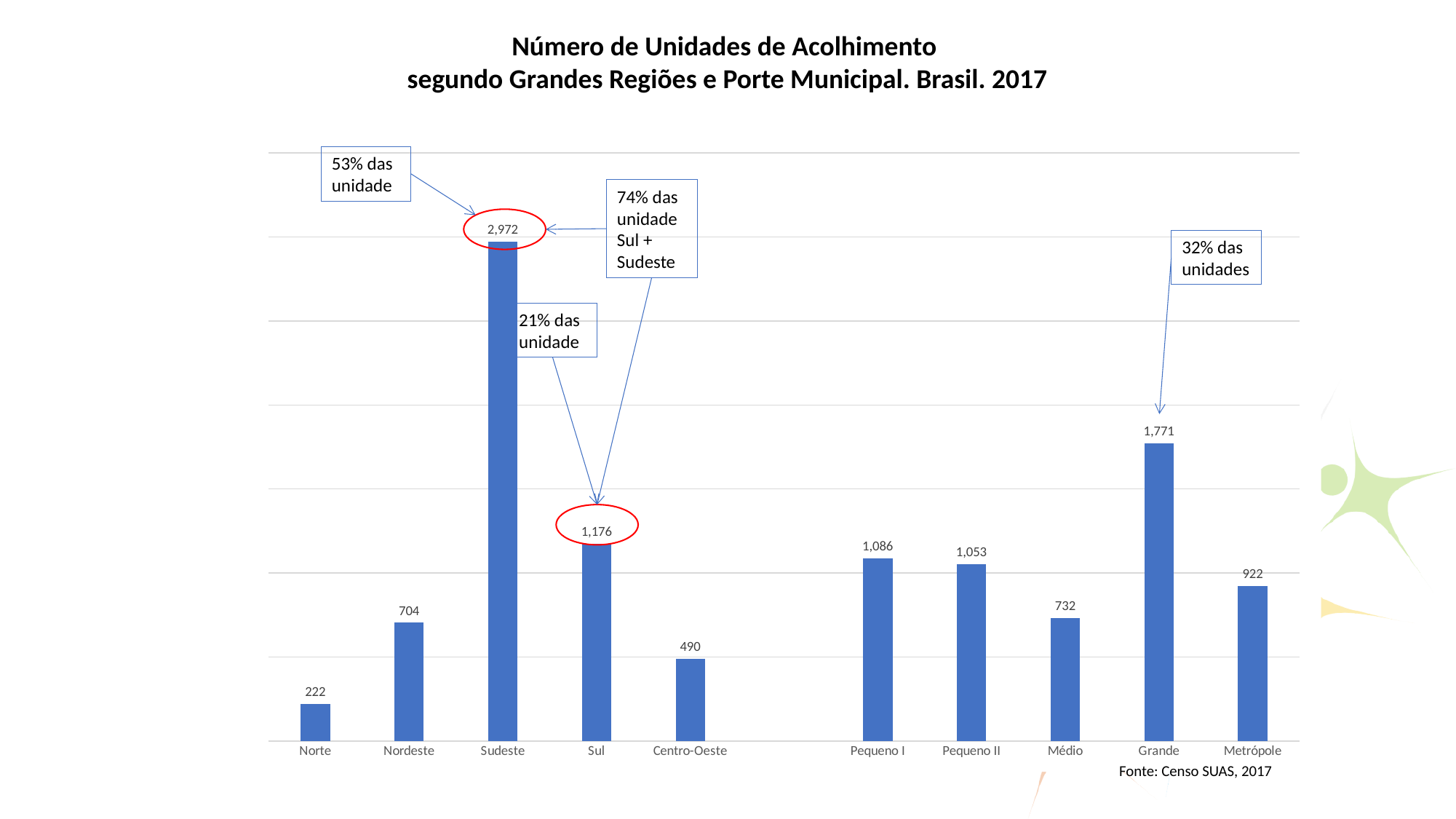
What kind of chart is shown on the slide? Bar chart What is the number of units for Médio? 732 What is the number of units for Sudeste? 2,972 What is the difference between the values for Grande and Metrópole? 849 Which is larger, the value for Nordeste or the value for Centro-Oeste? Nordeste Which region has the highest number of units? Sudeste What is the number of units for Grande? 1,771 Which category has the lowest value on the chart? Norte What is the difference between the values for Sudeste and Sul? 1,796 What is the number of units for Norte? 222 How many categories are shown on the x axis? 10 According to the annotation, what share of units does Sudeste represent? 53%